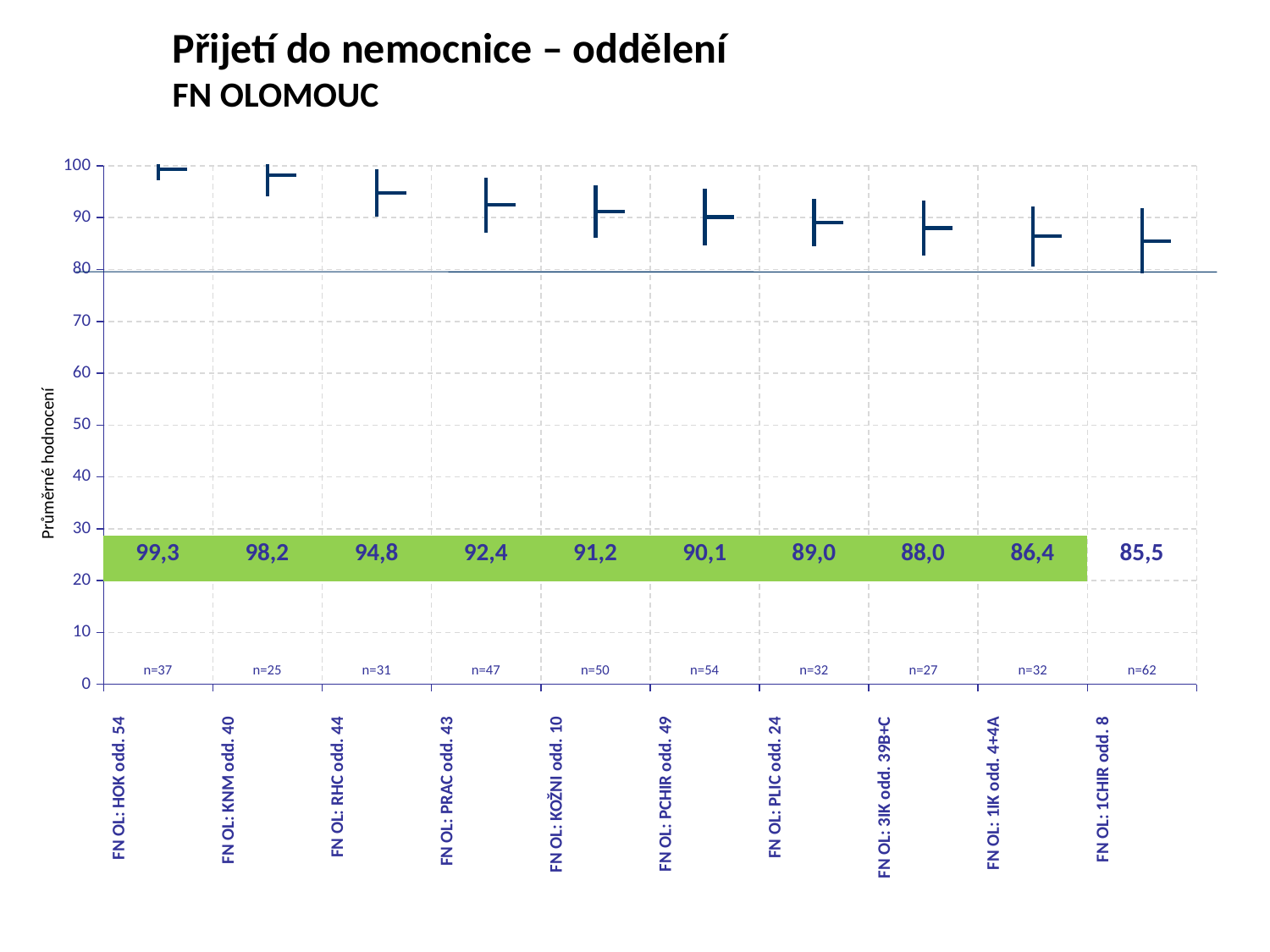
What is the sample size (n) shown for FN OL: KOŽNI odd. 10? n=50 What is the label of the vertical axis? Průměrné hodnocení What is the average rating for FN OL: HOK odd. 54? 99,3 Which has a higher average rating, FN OL: PCHIR odd. 49 or FN OL: PLIC odd. 24? FN OL: PCHIR odd. 49 What is the title of the chart? Přijetí do nemocnice – oddělení FN OLOMOUC Which department has the highest average rating? FN OL: HOK odd. 54 Which department has the lowest average rating? FN OL: 1CHIR odd. 8 What is the average rating for FN OL: 1CHIR odd. 8? 85,5 Do the average ratings rise or fall from left to right along the x axis? fall How many departments are shown on the chart? 10 What is the average rating for FN OL: PRAC odd. 43? 92,4 What is the difference between the average ratings of FN OL: KNM odd. 40 and FN OL: RHC odd. 44? 3,4